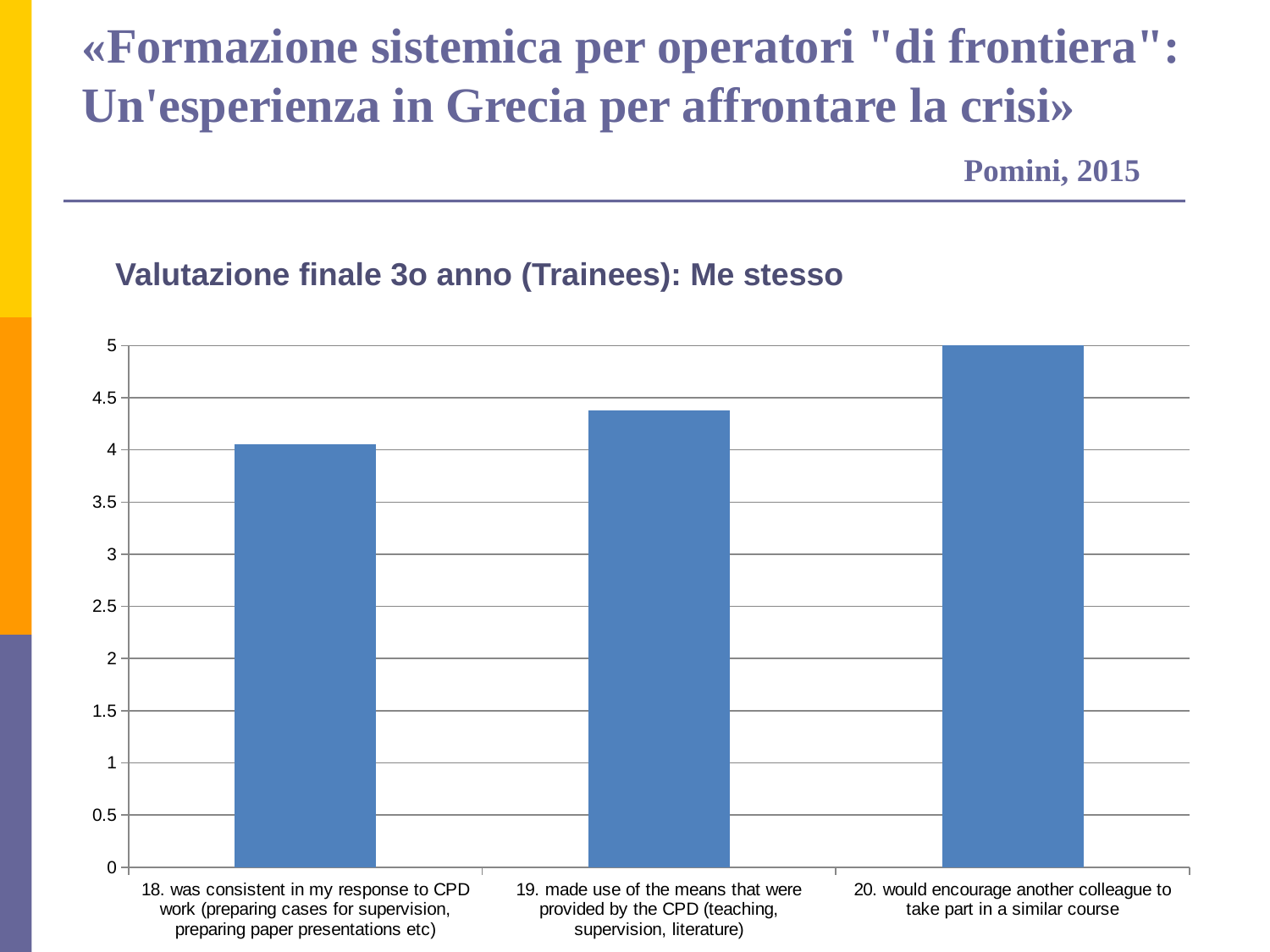
Do the values rise or fall moving from item 18 to item 20 along the x axis? rise Which item has the highest value in the chart? 20. would encourage another colleague to take part in a similar course Is the value for item 19, 'made use of the means that were provided by the CPD', greater or less than 4.5? less Is the value for item 18, 'was consistent in my response to CPD work', greater or less than 4.5? less Which has a larger value: item 18 (was consistent in my response to CPD work) or item 19 (made use of the means that were provided by the CPD)? 19. made use of the means that were provided by the CPD What is the value for item 20, 'would encourage another colleague to take part in a similar course'? 5 How many bars (categories) are plotted in the chart? 3 What is the maximum value shown on the vertical axis? 5 Which item has the lowest value in the chart? 18. was consistent in my response to CPD work (preparing cases for supervision, preparing paper presentations etc) Is the value for item 19, 'made use of the means that were provided by the CPD', greater or less than 4? greater What is the title of the chart? Valutazione finale 3o anno (Trainees): Me stesso What type of chart is shown on the slide? bar chart